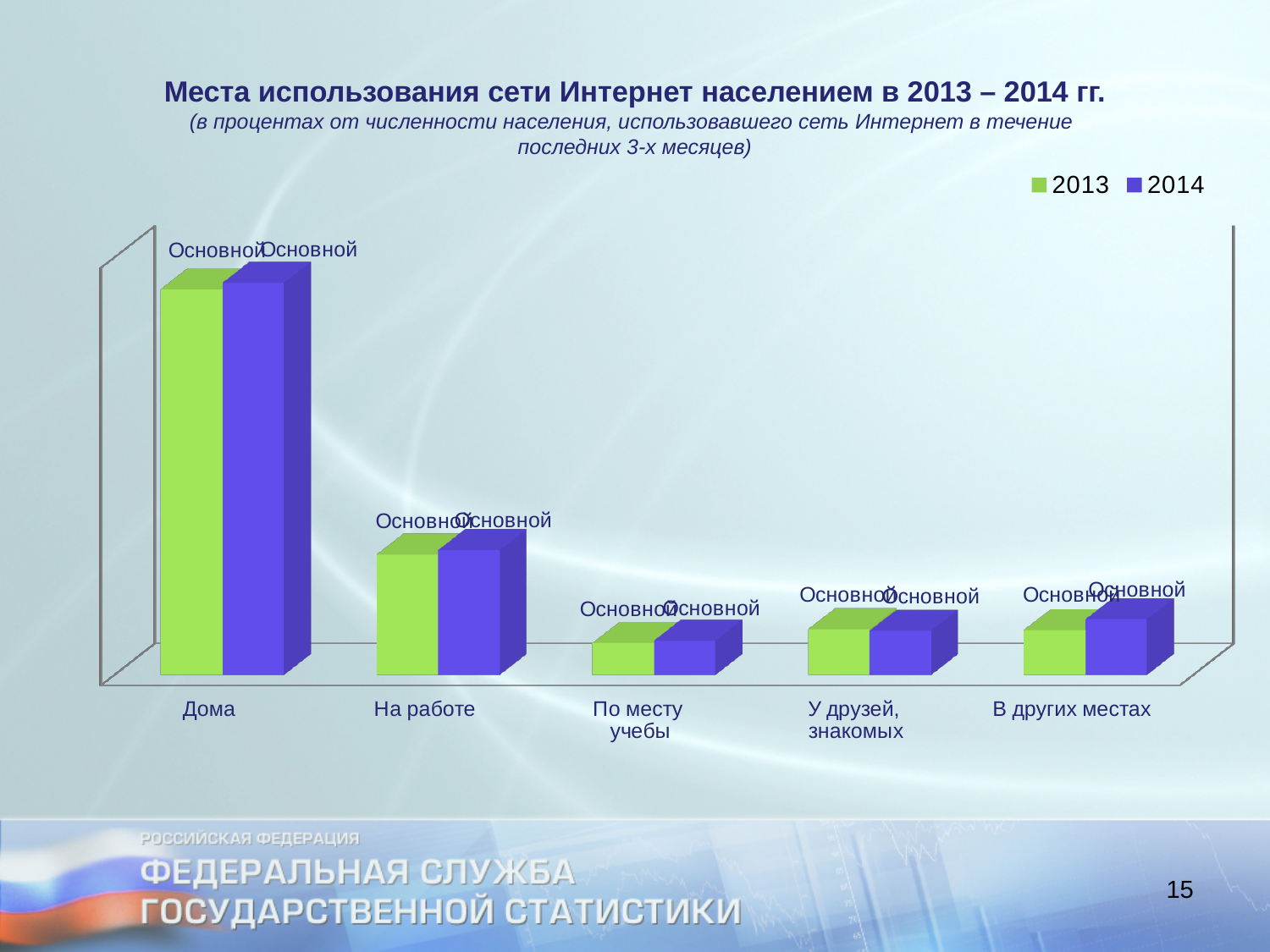
Which category has the highest value for 2013? Дома What years does the chart title say the data covers? 2013 – 2014 What kind of chart is shown on the slide? bar chart Which is larger for 2013: На работе or По месту учебы? На работе Which category has the lowest value for 2013? По месту учебы Which is larger for 2014: У друзей, знакомых or Дома? Дома How many series does the legend list? 2 Which category has the highest value for 2014? Дома How many categories are shown on the x axis? 5 Which is larger for 2014: Дома or На работе? Дома Which series is shown in green in the legend? 2013